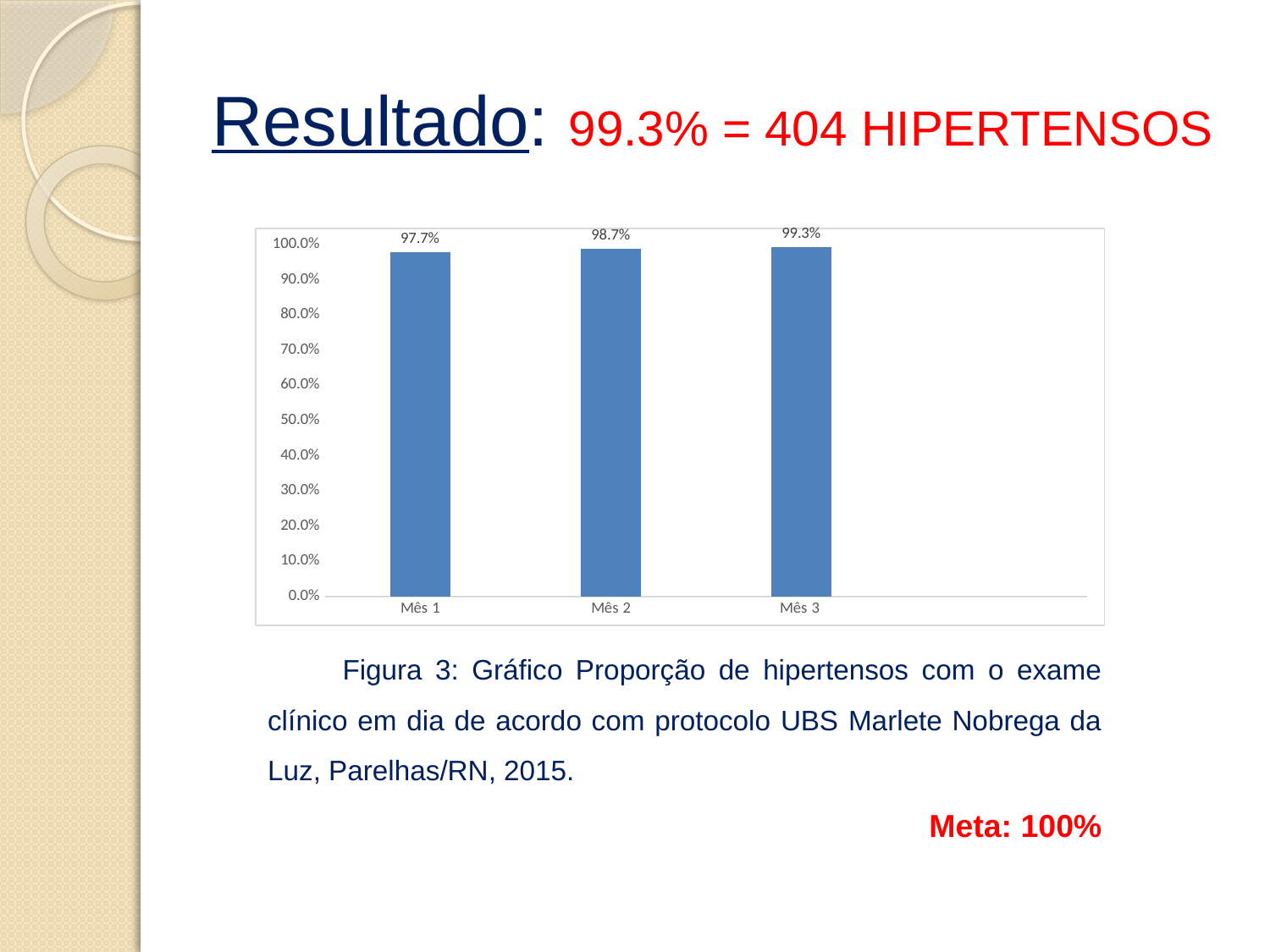
What is the difference between the values for Mês 3 and Mês 1? 1.6% What is the value for Mês 3? 99.3% Which month has the highest value? Mês 3 What kind of chart is shown on the slide? bar chart Is the value for Mês 1 greater or less than 90.0%? greater Which month has the lowest value? Mês 1 What is the value for Mês 2? 98.7% What is the difference between the values for Mês 2 and Mês 1? 1.0% Which is larger, the value for Mês 2 or the value for Mês 3? Mês 3 What is the value for Mês 1? 97.7% Do the values rise or fall from Mês 1 to Mês 3? rise How many months are shown on the x axis? 3